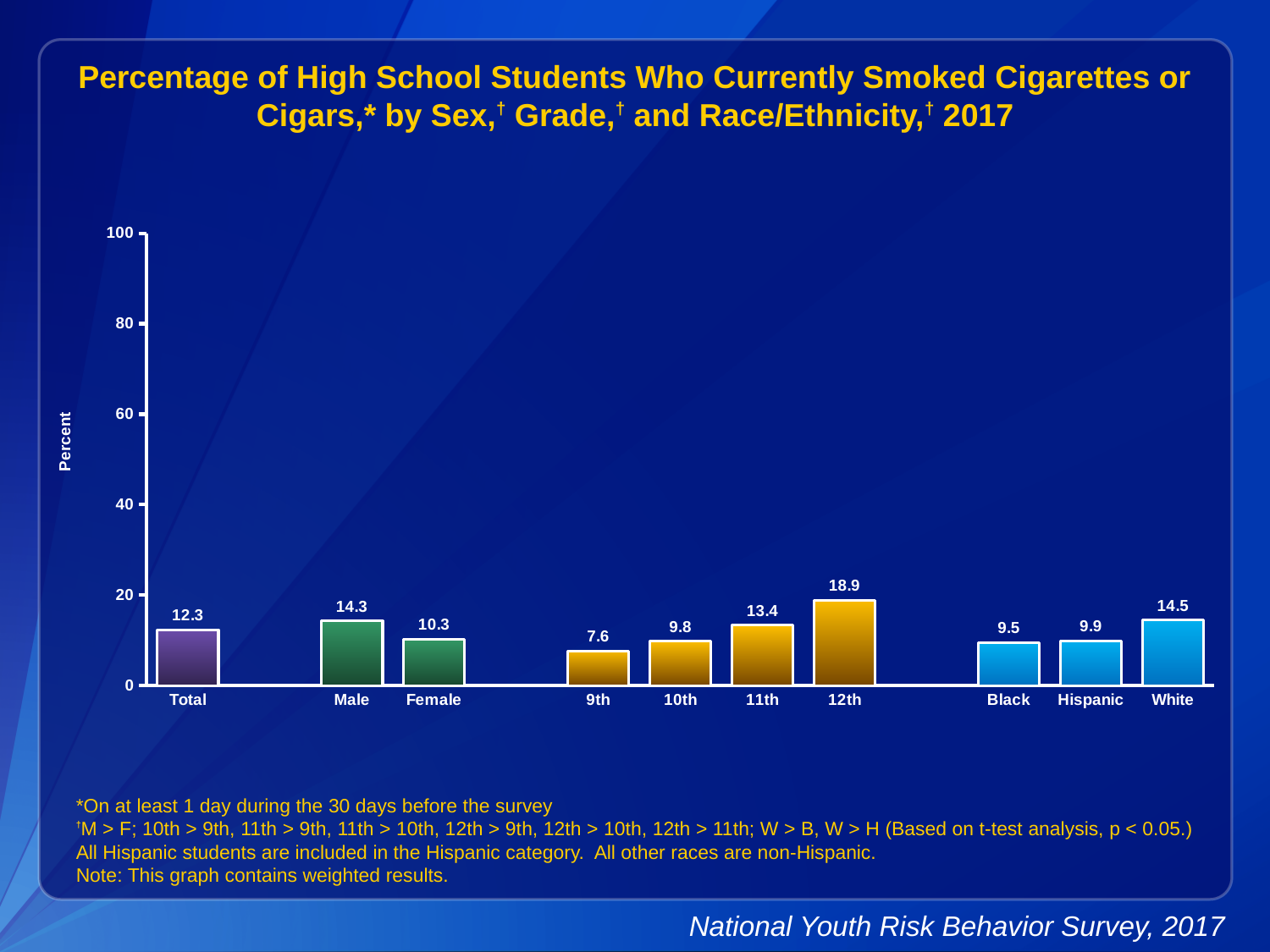
Which is larger, the value for White or the value for Black? White Do the values rise or fall from 9th grade to 12th grade? rise Is the value for 12th grade greater or less than 20? less How many categories are shown on the x axis? 10 What is the value for Total? 12.3 Which category has the highest value? 12th Which category has the lowest value? 9th What is the value for 12th grade? 18.9 What kind of chart is this? bar chart What is the value for Hispanic students? 9.9 What is the difference between the values for Male and Female? 4.0 What is the difference between the values for 12th and 9th grade? 11.3